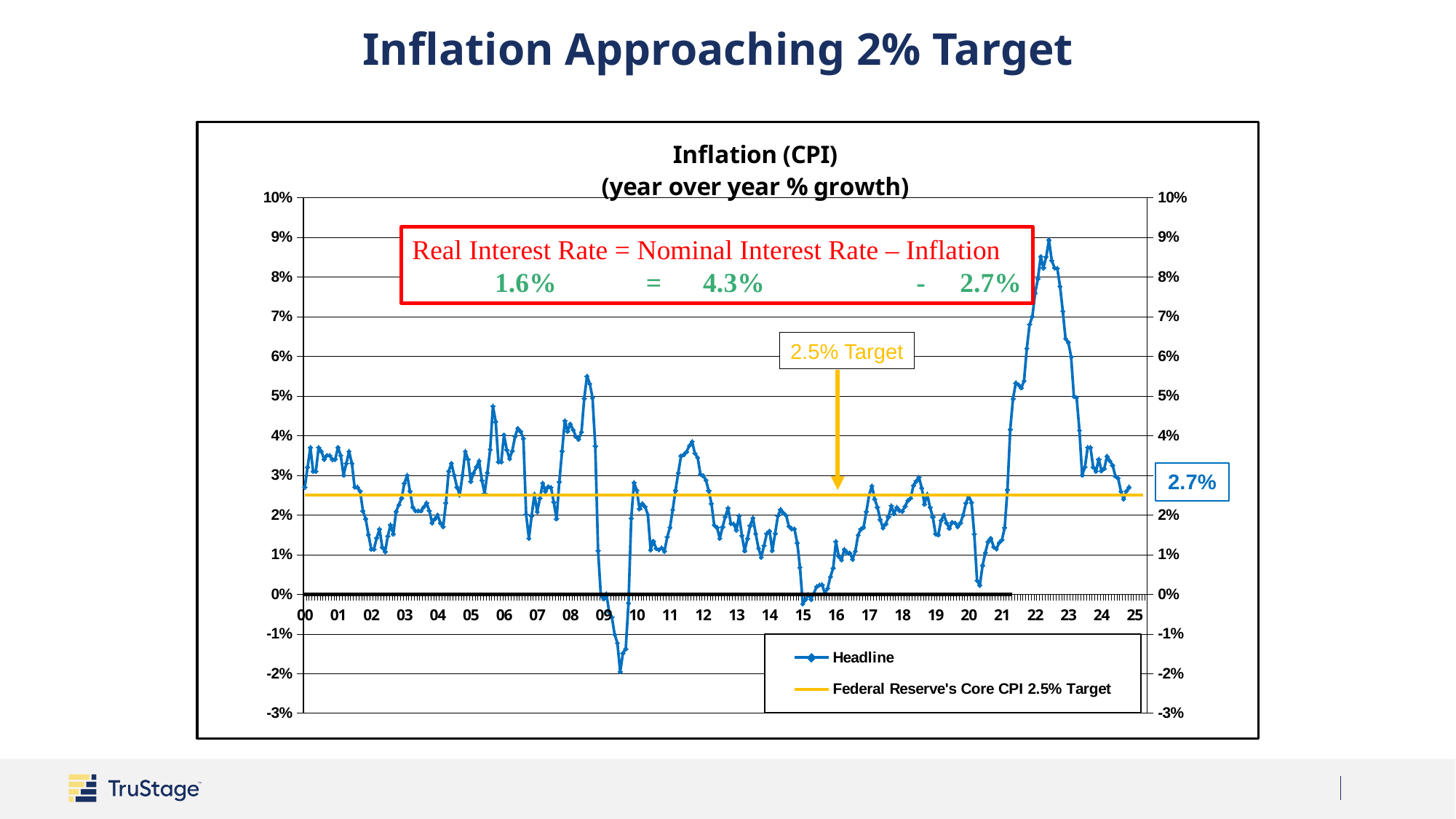
What is the value of the Federal Reserve's Core CPI target line? 2.5% How many series does the legend list? 2 Is the peak Headline inflation value in 2022 greater or less than 8%? greater What is the most recent Headline inflation value labeled on the chart? 2.7% Does Headline inflation rise or fall from its 2022 peak to 2024? fall What kind of chart is shown on the slide? line chart In which year does Headline inflation reach its lowest point? 2009 Is the lowest Headline inflation value in 2009 greater or less than -1%? less In which year does Headline inflation reach its highest point? 2022 By how much does the latest Headline inflation value of 2.7% exceed the 2.5% target? 0.2% Which is larger, the latest Headline inflation value or the Federal Reserve's 2.5% target? the latest Headline value (2.7%) Is the Headline inflation value in 2015 greater or less than 1%? less